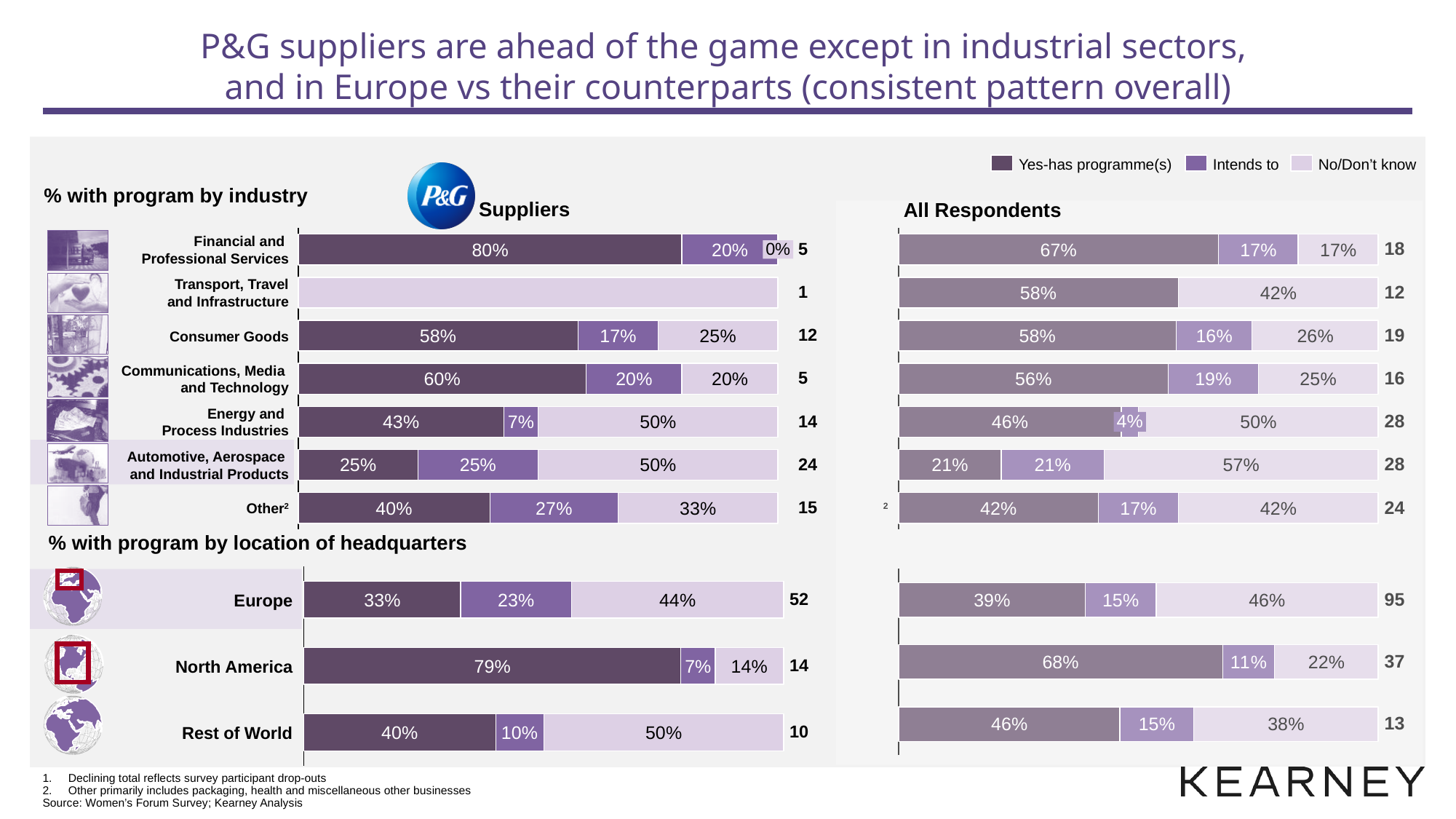
How many industry categories are shown in the '% with program by industry' charts? 7 What is the difference between the 'Yes-has programme(s)' percentage for Europe in the P&G Suppliers chart and in the All Respondents chart? 6% What kind of chart is used to show the '% with program by location of headquarters' data? Stacked bar chart In the All Respondents chart by location of headquarters, what is the 'No/Don't know' value for Rest of World? 38% In the All Respondents chart by industry, which industry has the lowest 'Yes-has programme(s)' percentage? Automotive, Aerospace and Industrial Products In the P&G Suppliers chart by location of headquarters, what is the 'Yes-has programme(s)' value for North America? 79% In the All Respondents chart by industry, how many respondents (n) are in the Energy and Process Industries category? 28 In the P&G Suppliers chart by industry, which is larger: the 'Intends to' value for Consumer Goods or for Communications, Media and Technology? Communications, Media and Technology How many series does the legend list? 3 In the P&G Suppliers chart by industry, what percentage of Financial and Professional Services suppliers have a programme? 80% In the All Respondents chart by industry, what percentage of Consumer Goods respondents intend to have a programme? 16% In the P&G Suppliers chart by industry, which industry has the highest 'Yes-has programme(s)' percentage? Financial and Professional Services